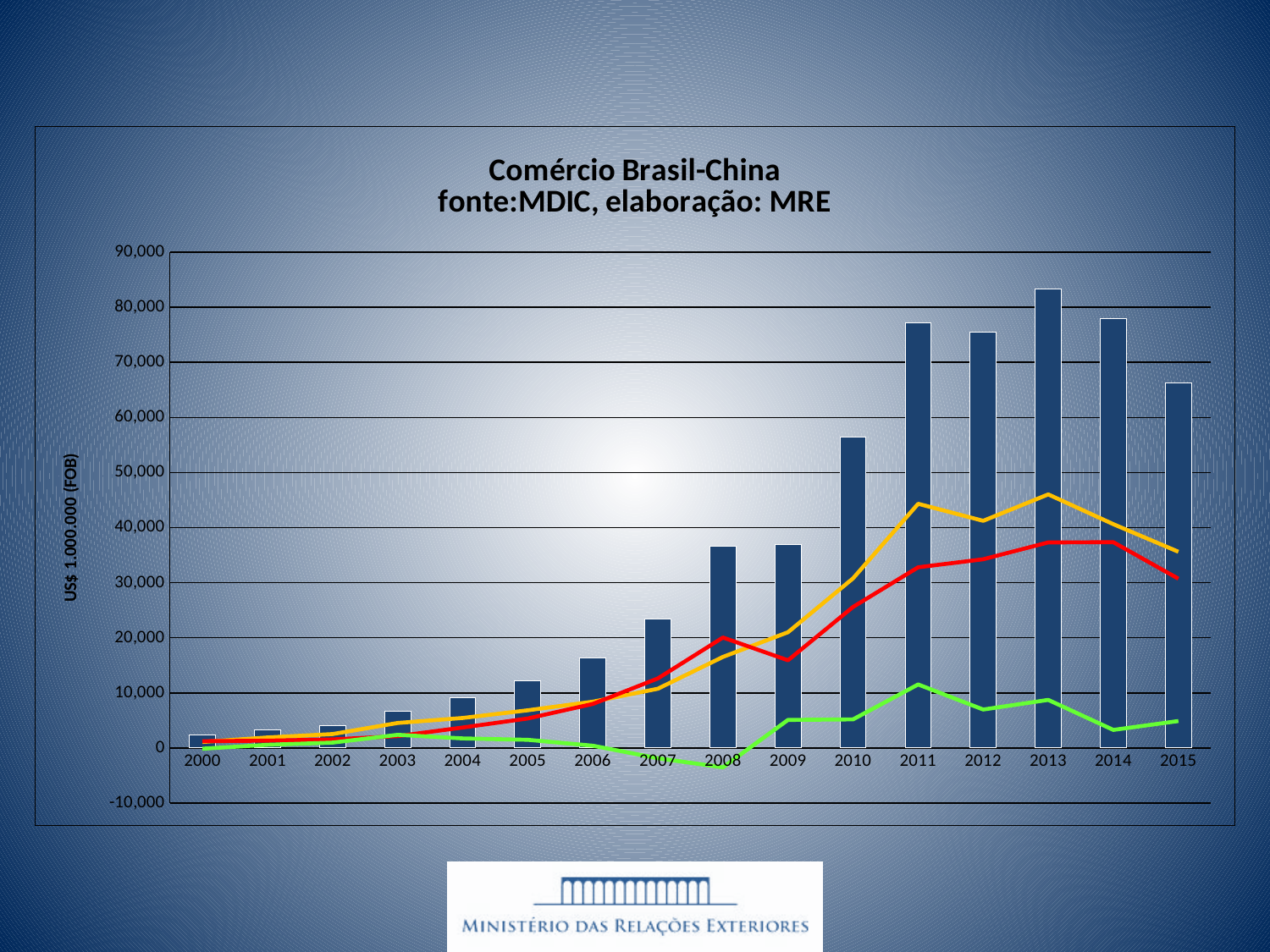
What kind of chart is shown on the slide? A bar chart combined with line series What is the title of the chart? Comércio Brasil-China fonte:MDIC, elaboração: MRE Is the bar for 2010 greater or less than 50,000? greater Which year has the shortest bar in the chart? 2000 Which year has the tallest bar in the chart? 2013 Do the bars generally rise or fall from 2000 to 2013? rise Which bar is taller, 2013 or 2014? 2013 Is the yellow line's value for 2013 greater or less than 40,000? greater Is the bar for 2015 greater or less than 70,000? less How many years are shown on the x axis of the chart? 16